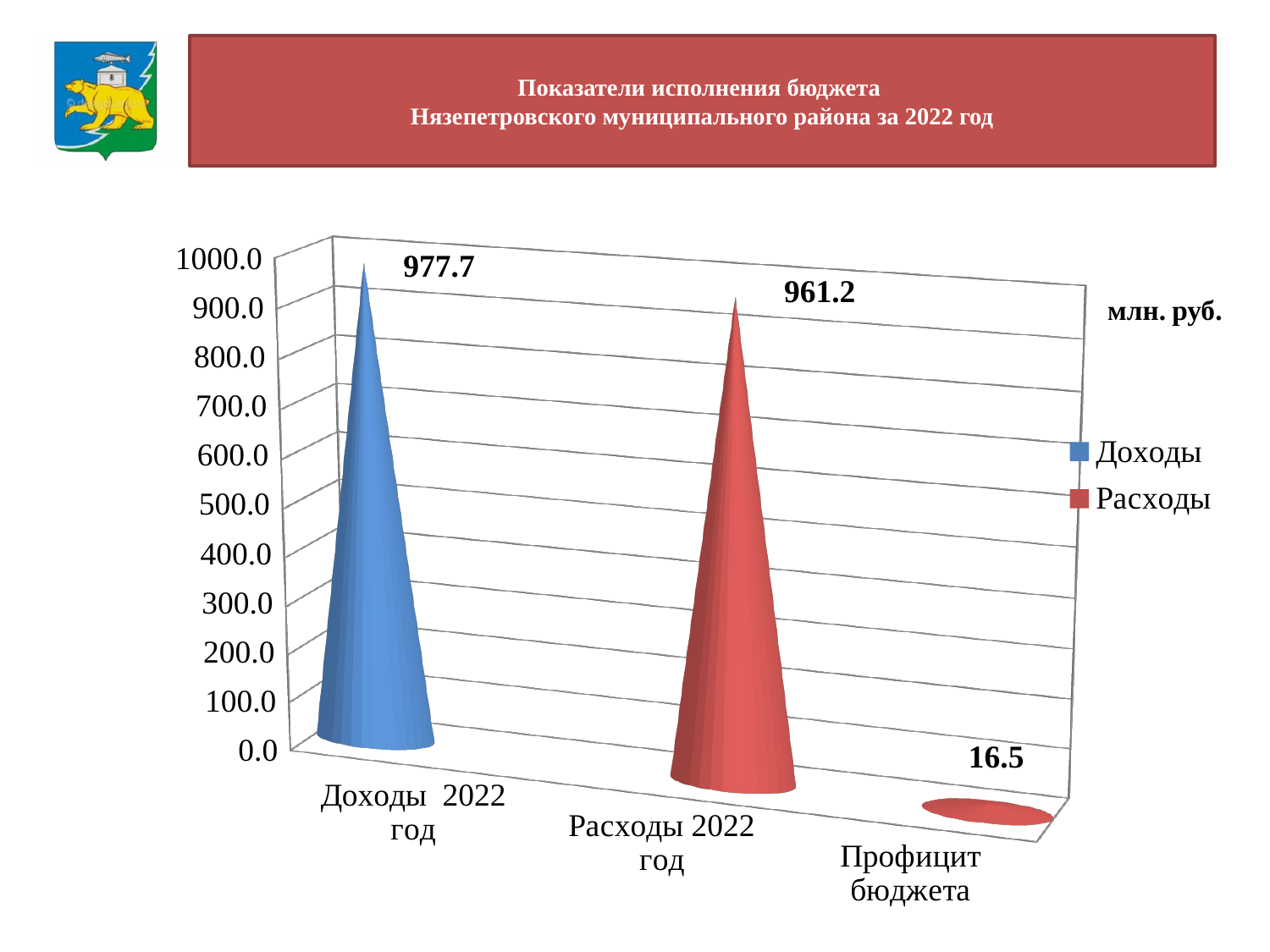
Is the value for Расходы 2022 год greater or less than 900.0? greater What is the value shown for Расходы 2022 год? 961.2 How many series does the legend list? 2 What is the value shown for Доходы 2022 год? 977.7 What unit of measurement is indicated on the chart? млн. руб. How many categories are shown on the x axis? 3 Which category has the lowest value? Профицит бюджета Which is larger, Доходы 2022 год or Расходы 2022 год? Доходы 2022 год What is the difference between Доходы 2022 год and Расходы 2022 год? 16.5 Which category has the highest value? Доходы 2022 год What kind of chart is shown on the slide? bar chart What is the value shown for Профицит бюджета? 16.5